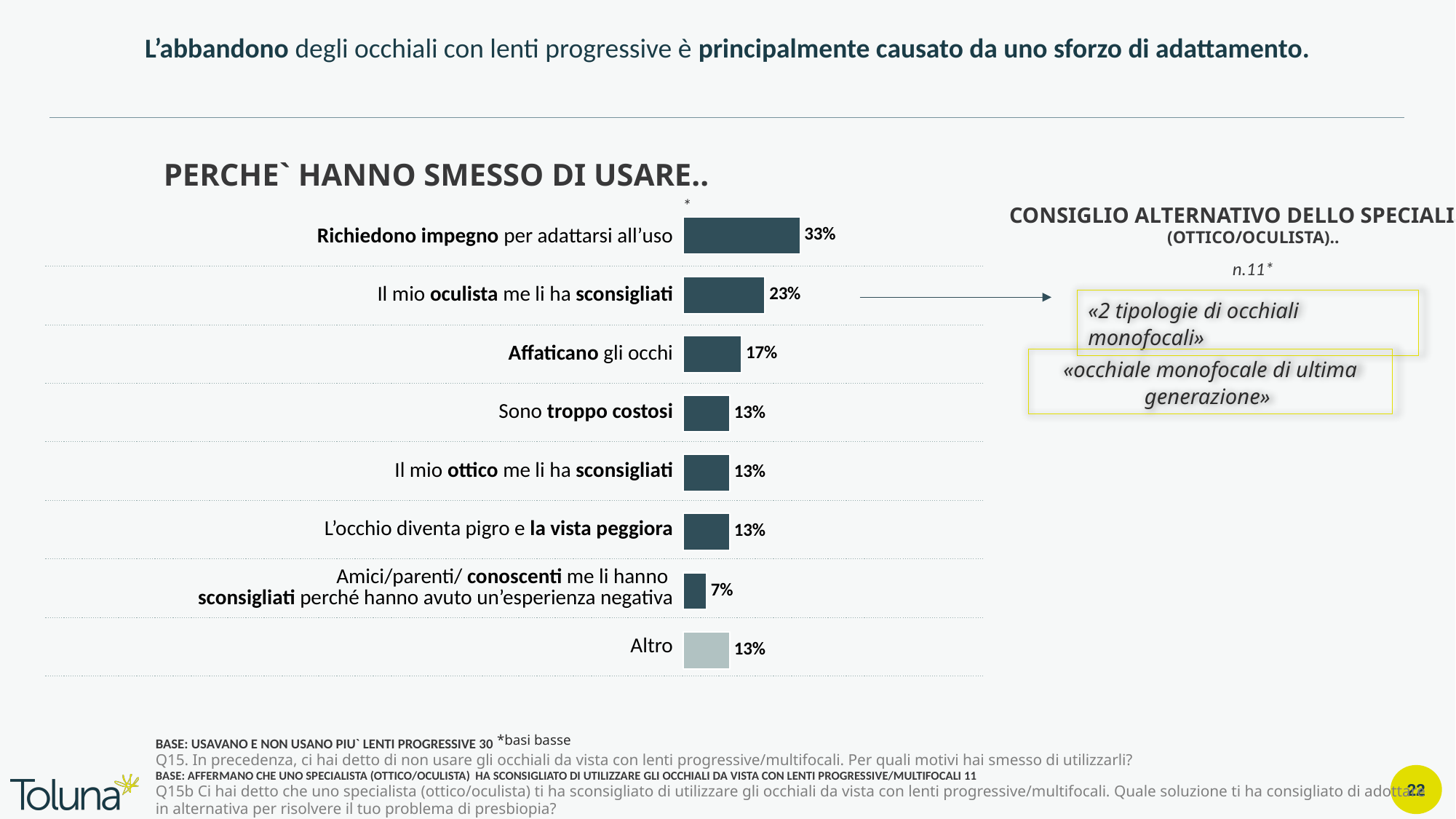
How many reasons (categories) are shown in the bar chart? 8 What is the value for 'Amici/parenti/conoscenti me li hanno sconsigliati perché hanno avuto un'esperienza negativa'? 7% What is the title of the chart? PERCHE` HANNO SMESSO DI USARE.. What percentage of respondents said the glasses 'Richiedono impegno per adattarsi all'uso'? 33% Which reason has the highest percentage in the chart? Richiedono impegno per adattarsi all'uso What percentage is shown for 'Affaticano gli occhi'? 17% Which bar is shown in a lighter colour than the others? Altro What type of chart is used to show why people stopped using progressive lenses? Bar chart Which is larger: 'Affaticano gli occhi' or 'Sono troppo costosi'? Affaticano gli occhi Which reason has the lowest percentage in the chart? Amici/parenti/conoscenti me li hanno sconsigliati perché hanno avuto un'esperienza negativa What is the value for 'Il mio oculista me li ha sconsigliati'? 23% What is the difference between 'Richiedono impegno per adattarsi all'uso' and 'Il mio oculista me li ha sconsigliati'? 10%